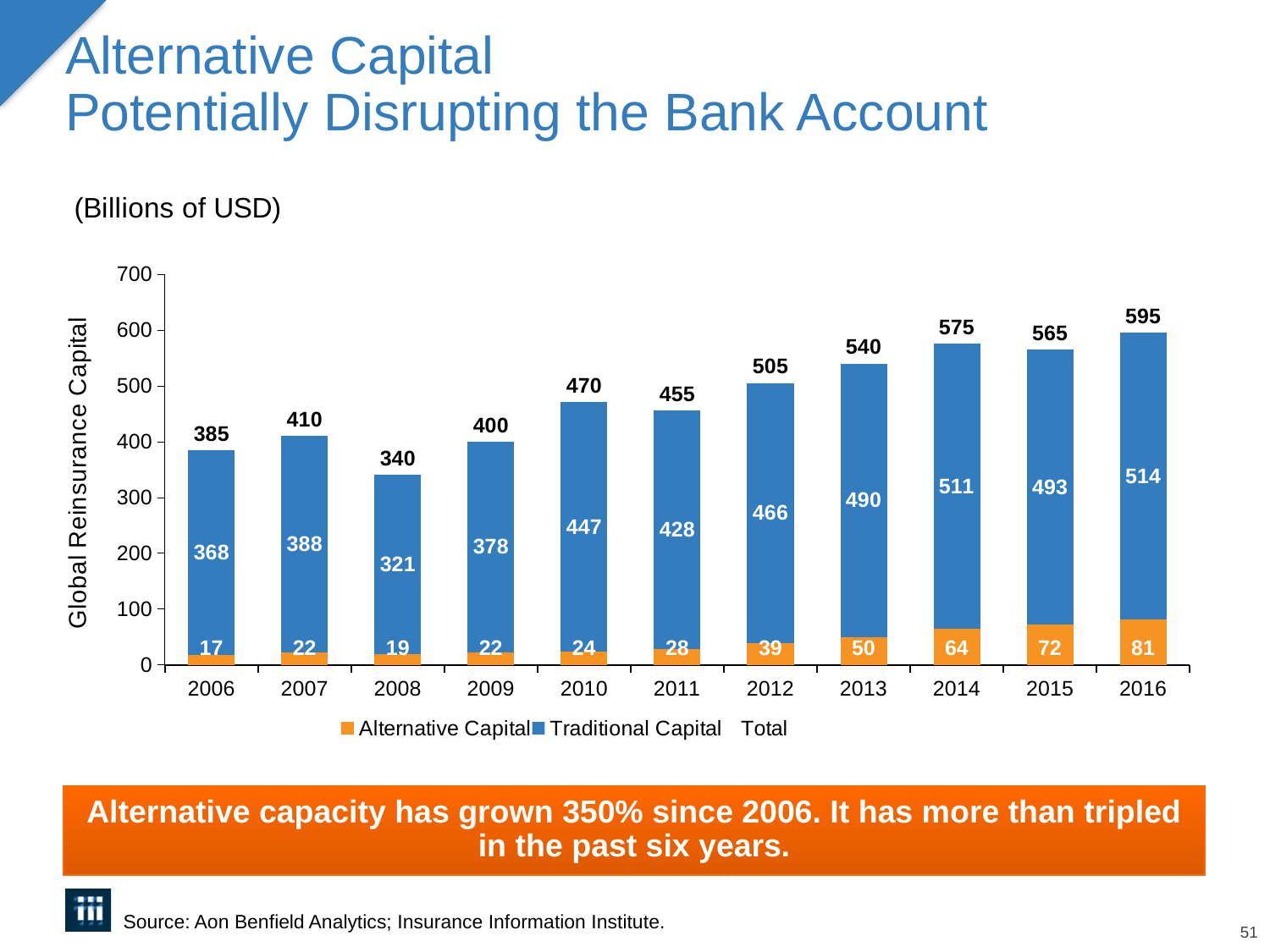
What is the Traditional Capital value for 2010? 447 Which year has the highest Alternative Capital value? 2016 What is the Total value shown for 2013? 540 How many entries does the legend list? 3 What is the Alternative Capital value for 2016? 81 Which is larger, the Traditional Capital value for 2014 or for 2015? 2014 Which year has the lowest Total global reinsurance capital? 2008 What kind of chart is shown on the slide? Stacked bar chart What is the difference between the Total for 2016 and the Total for 2006? 210 How many years are shown on the x axis? 11 Is the Total for 2012 greater or less than 500? greater What is the label on the vertical axis? Global Reinsurance Capital